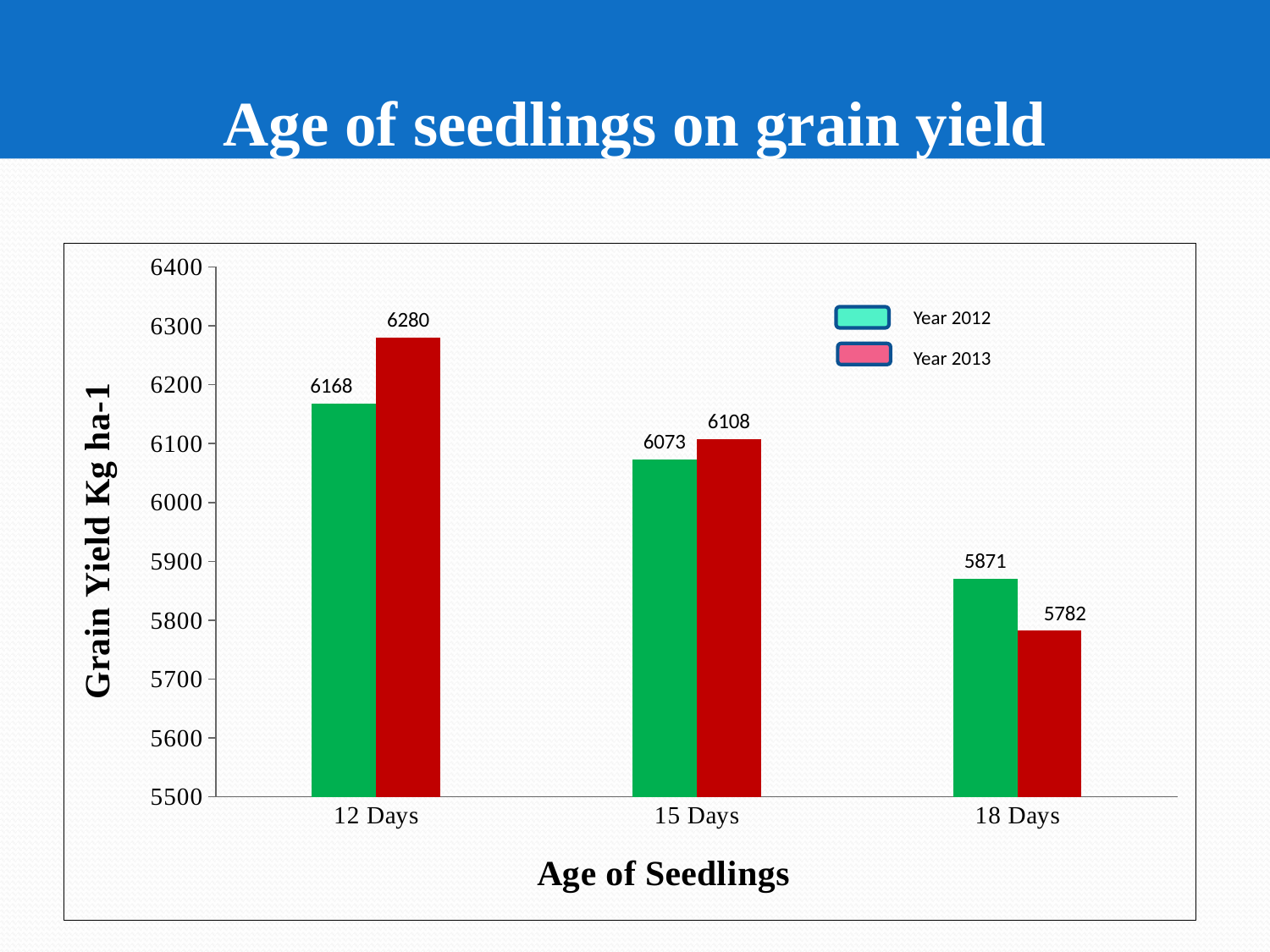
Is the Year 2012 grain yield at 15 Days greater or less than 6000? greater What is the grain yield for Year 2012 at 12 Days? 6168 Do the Year 2013 grain yields rise or fall as seedling age increases from 12 Days to 18 Days? Fall What is the difference between the Year 2013 and Year 2012 grain yields at 12 Days? 112 How many series does the legend list? 2 What is the grain yield for Year 2013 at 15 Days? 6108 What kind of chart is shown on the slide? Bar chart Which seedling age has the lowest grain yield for Year 2012? 18 Days What is the grain yield for Year 2013 at 18 Days? 5782 Which seedling age has the highest grain yield for Year 2013? 12 Days At 18 Days, which year has the larger grain yield, Year 2012 or Year 2013? Year 2012 How many seedling age categories are shown on the x axis? 3